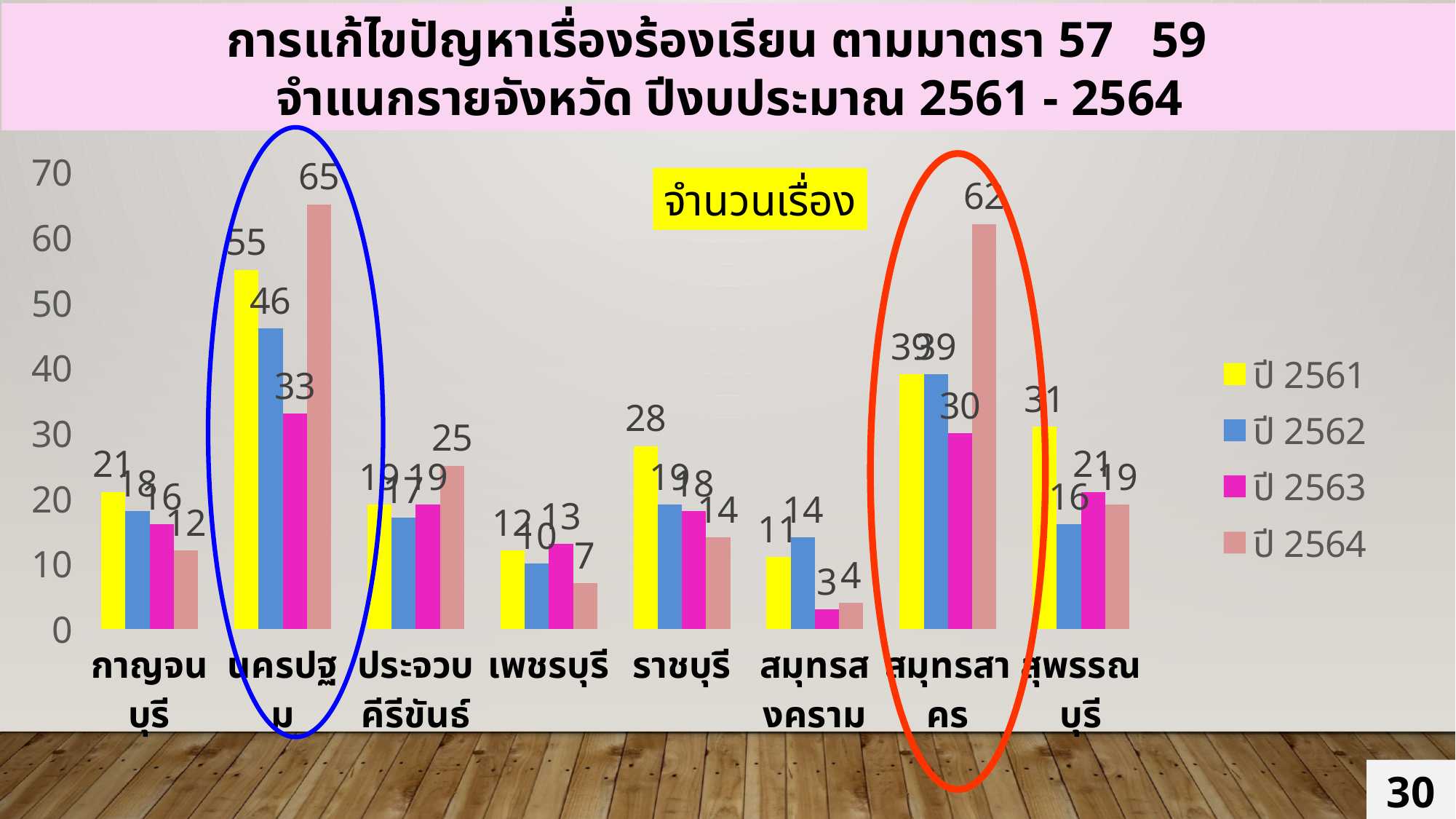
What is the value for สมุทรสาคร in ปี 2564? 62 Is the value for สมุทรสาคร in ปี 2563 greater or less than 40? less Which province has the highest value for ปี 2564? นครปฐม Which province has the lowest value for ปี 2564? สมุทรสงคราม What is the difference between the ปี 2564 and ปี 2561 values for นครปฐม? 10 What is the value for นครปฐม in ปี 2564? 65 What is the value for นครปฐม in ปี 2562? 46 How many provinces are shown on the x axis? 8 Which province is circled in blue on the chart? นครปฐม How many series does the legend list? 4 What kind of chart is shown on the slide? bar chart Which is larger for ปี 2561: ราชบุรี or สุพรรณบุรี? สุพรรณบุรี